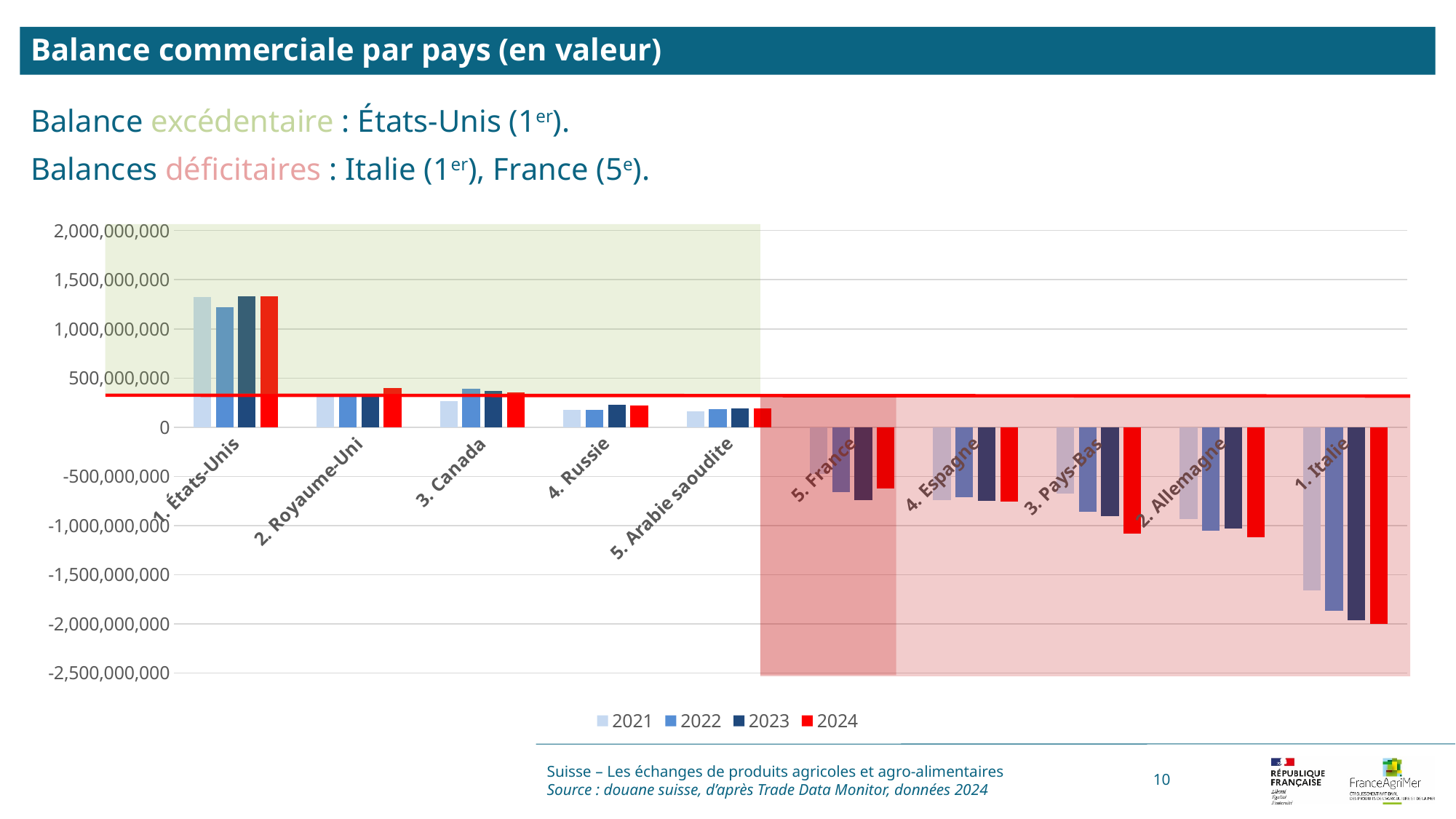
Which country has the lowest 2024 value in the chart? 1. Italie Is the 2024 value for Royaume-Uni greater or less than 500,000,000? less What kind of chart is shown on the slide? bar chart Which is larger, the 2024 value for États-Unis or the 2024 value for Canada? États-Unis Is the 2024 value for France greater or less than -500,000,000? less How many series does the chart legend list? 4 How many countries are shown on the x axis of the chart? 10 Is the 2024 value for États-Unis greater or less than 1,000,000,000? greater What is the title of the chart slide? Balance commerciale par pays (en valeur) Do the values for Italie rise or fall from 2021 to 2024? fall Which country has the highest 2024 value in the chart? 1. États-Unis